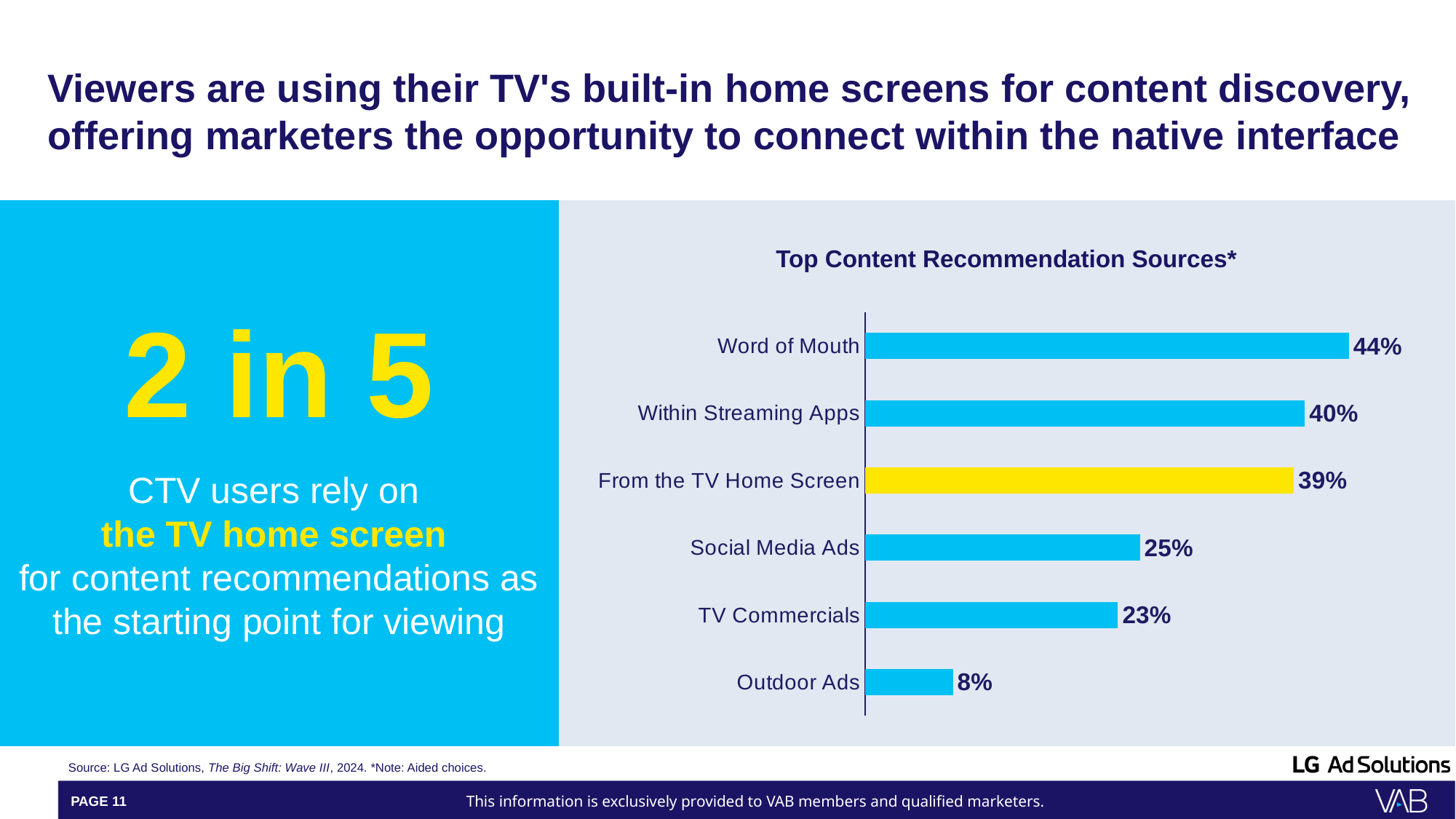
What is the difference between Social Media Ads and Outdoor Ads? 17% What is the difference between Word of Mouth and Within Streaming Apps? 4% Which category has the highest value? Word of Mouth Which category has the lowest value? Outdoor Ads What is the value for From the TV Home Screen? 39% How many categories are shown in the chart? 6 What is the value for TV Commercials? 23% What kind of chart is shown on the slide? Bar chart Which is larger, Social Media Ads or TV Commercials? Social Media Ads What is the value for Outdoor Ads? 8% What is the title of the chart? Top Content Recommendation Sources* What is the value for Word of Mouth? 44%